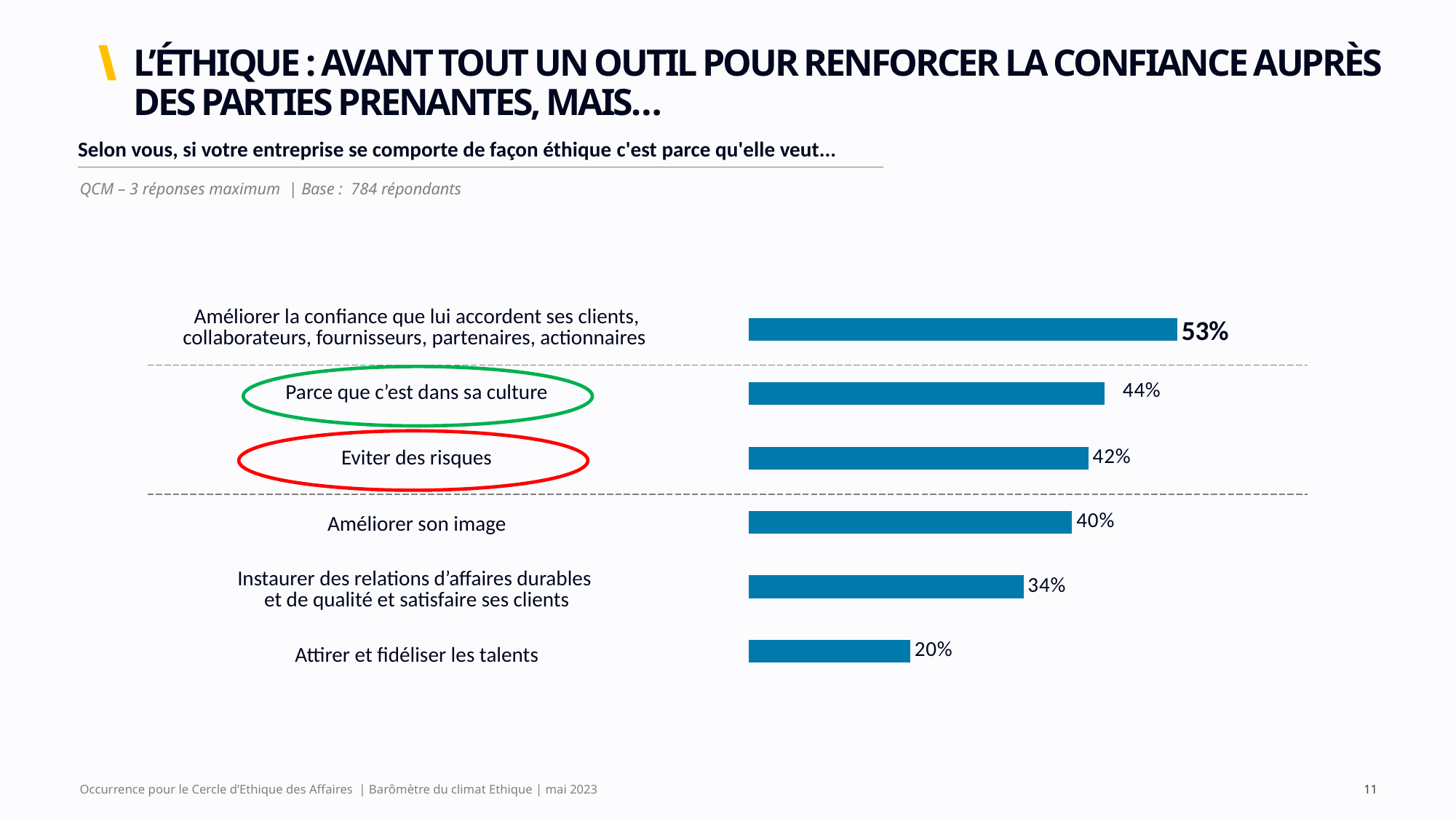
What percentage of respondents chose "Parce que c'est dans sa culture"? 44% What is the value shown for "Eviter des risques"? 42% Which category label is circled in red? Eviter des risques What is the difference between the highest value (53%) and the value for "Attirer et fidéliser les talents" (20%)? 33 percentage points How many categories are shown in the chart? 6 Which category has the lowest value? Attirer et fidéliser les talents What kind of chart is shown on the slide? Bar chart What is the value for "Améliorer son image"? 40% Which category has the highest value? Améliorer la confiance que lui accordent ses clients, collaborateurs, fournisseurs, partenaires, actionnaires Which is larger: the value for "Améliorer son image" or the value for "Instaurer des relations d'affaires durables et de qualité et satisfaire ses clients"? Améliorer son image What percentage is shown for "Attirer et fidéliser les talents"? 20% What is the difference between "Parce que c'est dans sa culture" and "Eviter des risques"? 2 percentage points